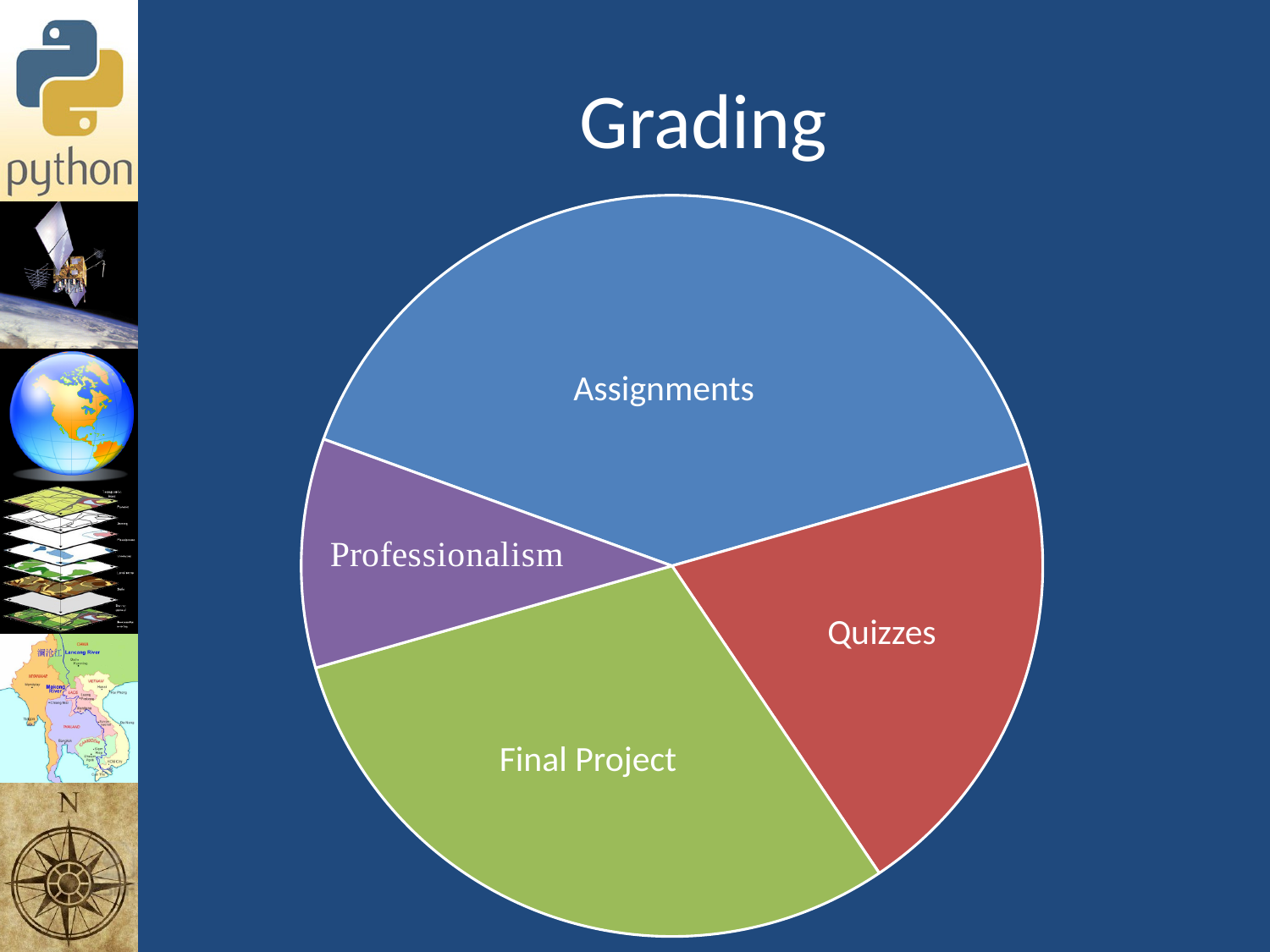
Which category has the largest slice of the pie chart? Assignments How many slices does the pie chart have? 4 Which slice is larger, Assignments or Quizzes? Assignments Which category has the smallest slice of the pie chart? Professionalism Which slice is larger, Quizzes or Professionalism? Quizzes What kind of chart is shown on the slide? pie chart Which category has the second-largest slice of the pie chart? Final Project Which slice is larger, Final Project or Professionalism? Final Project What colour is the Final Project slice of the pie chart? green What is the title of the slide containing the pie chart? Grading